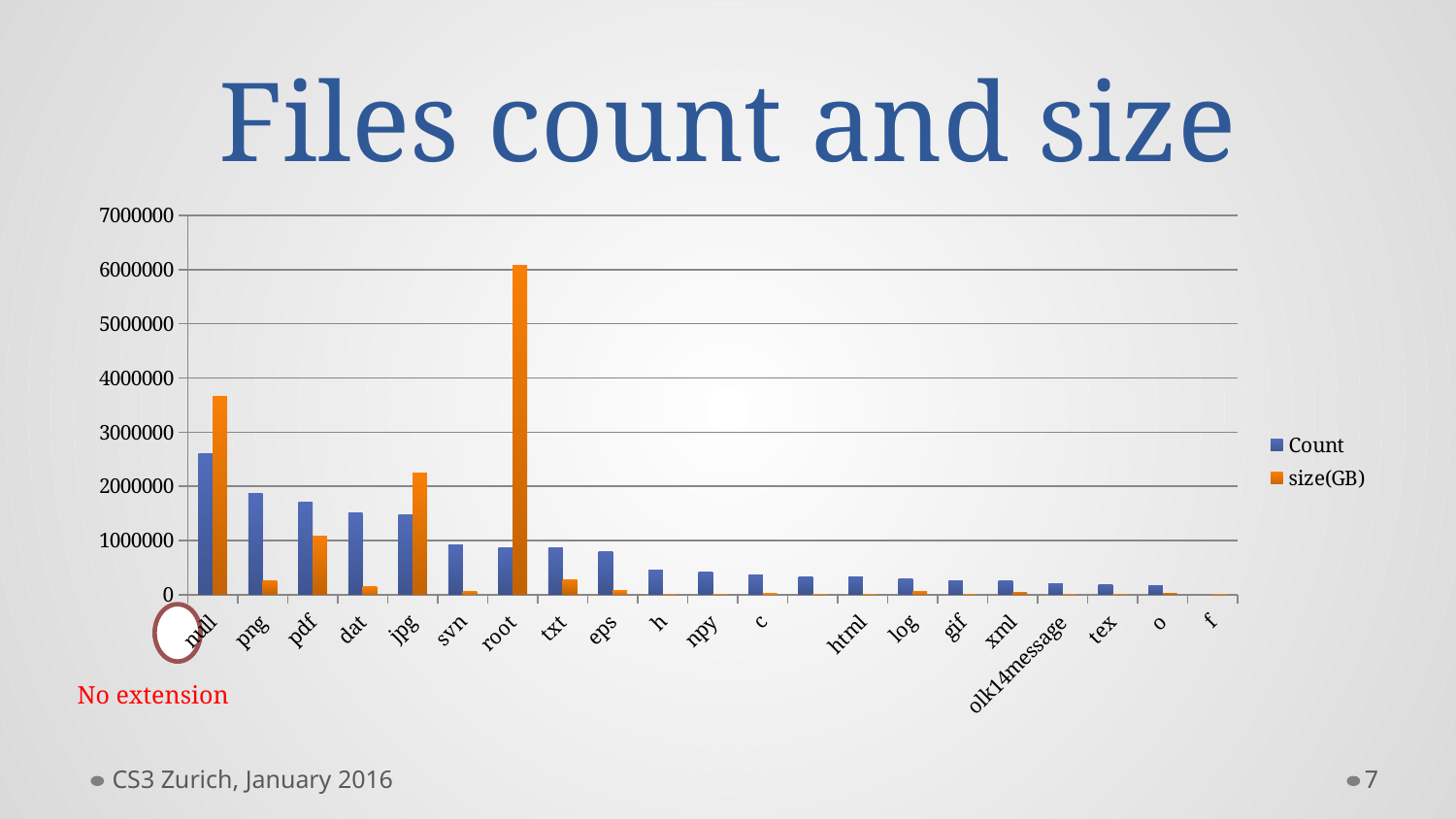
Which is larger, the size(GB) value for root or for null? root Is the size(GB) value for jpg greater or less than 2000000? greater Which category has the highest size(GB) value? root What is the title of the chart? Files count and size Is the size(GB) value for null greater or less than 3000000? greater Which category has the highest Count value? null Is the Count value for pdf greater or less than 1000000? greater How many series does the legend list? 2 Do the Count values generally rise or fall from left to right along the x axis? fall What kind of chart is shown on the slide? bar chart